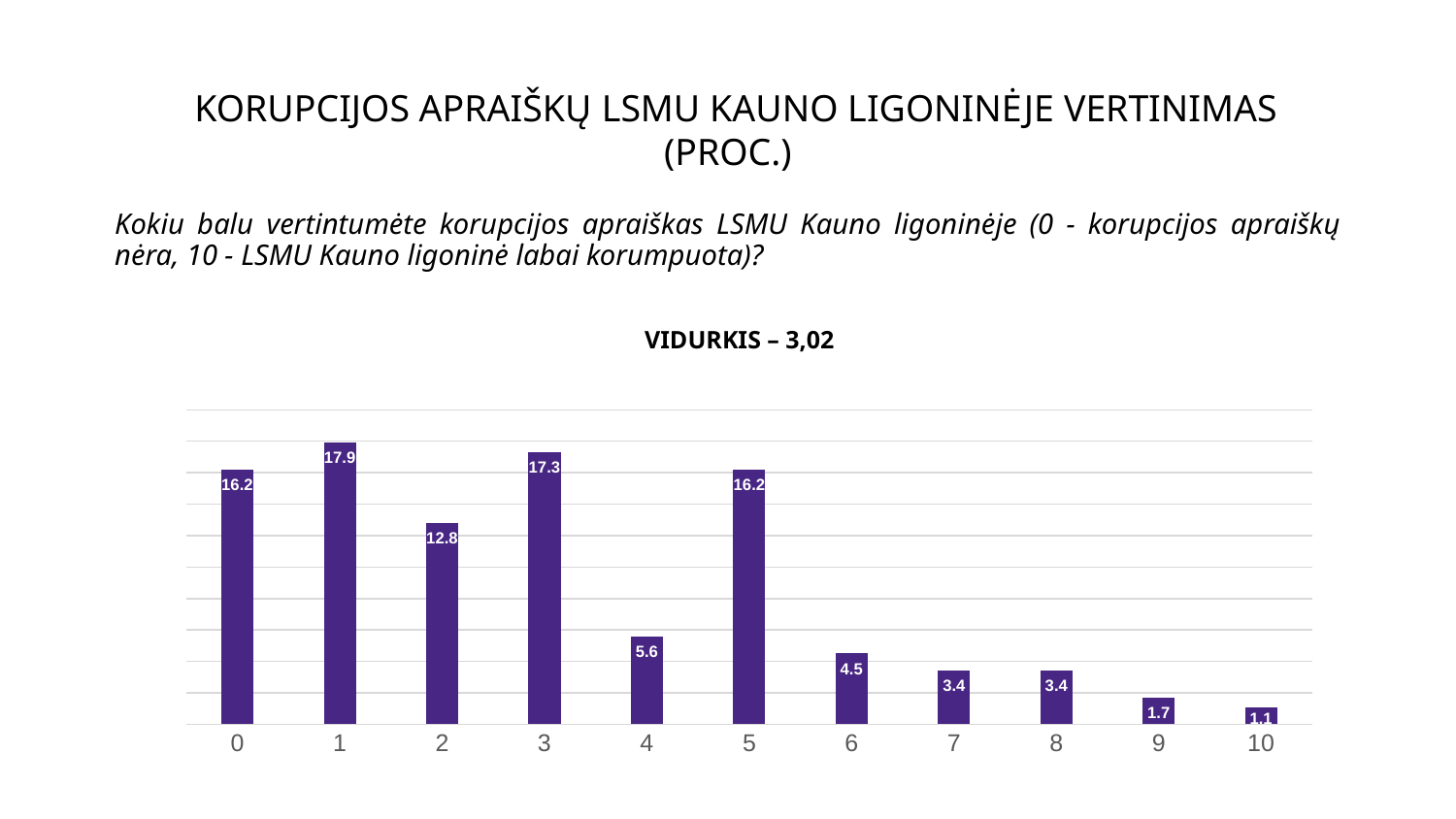
What is the difference between the values for score 3 and score 2? 4.5 How many score categories are shown on the x axis? 11 What kind of chart is shown on the slide? bar chart What is the difference between the values for score 1 and score 0? 1.7 Which score has the highest bar? 1 What percentage of respondents gave a score of 1? 17.9 Which is larger, the value for score 2 or the value for score 4? score 2 What average (vidurkis) is stated above the chart? 3,02 Which score has the lowest bar? 10 What is the value shown for score 4? 5.6 What is the value shown for score 10? 1.1 Do the values rise or fall from score 5 to score 10? fall